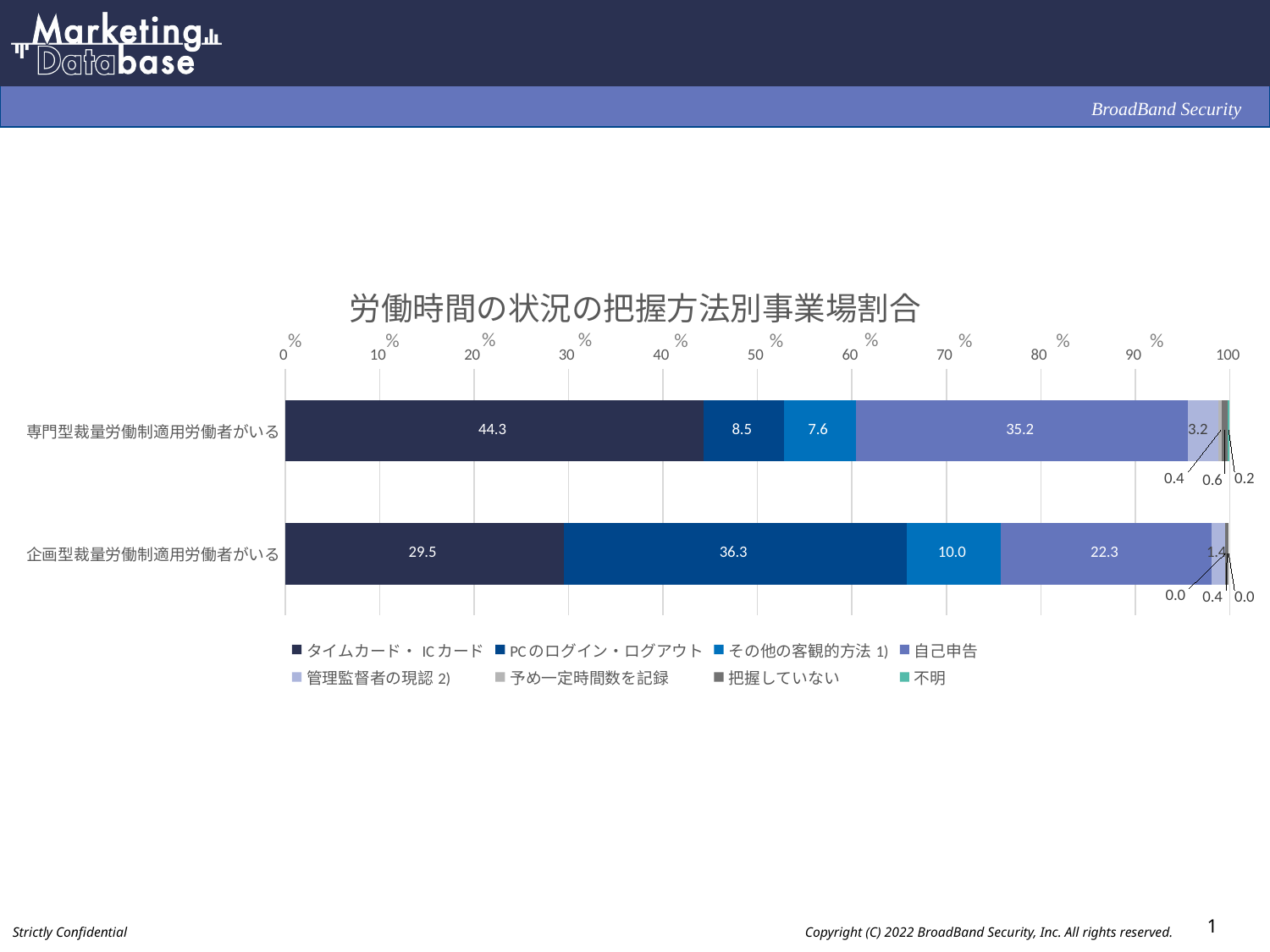
What is the value of PCのログイン・ログアウト for 企画型裁量労働制適用労働者がいる? 36.3 What is the value of タイムカード・ICカード for 専門型裁量労働制適用労働者がいる? 44.3 What is the difference between the タイムカード・ICカード values for 専門型裁量労働制適用労働者がいる and 企画型裁量労働制適用労働者がいる? 14.8 What type of chart is shown on the slide? Stacked bar chart What is the value of その他の客観的方法 1) for 企画型裁量労働制適用労働者がいる? 10.0 Which category has the larger value for 自己申告, 専門型裁量労働制適用労働者がいる or 企画型裁量労働制適用労働者がいる? 専門型裁量労働制適用労働者がいる What is the title of the chart? 労働時間の状況の把握方法別事業場割合 How many categories (bars) are plotted in the chart? 2 Which series has the largest value in the 専門型裁量労働制適用労働者がいる bar? タイムカード・ICカード How many series does the legend list? 8 What is the value of 自己申告 for 専門型裁量労働制適用労働者がいる? 35.2 Which series has the largest value in the 企画型裁量労働制適用労働者がいる bar? PCのログイン・ログアウト